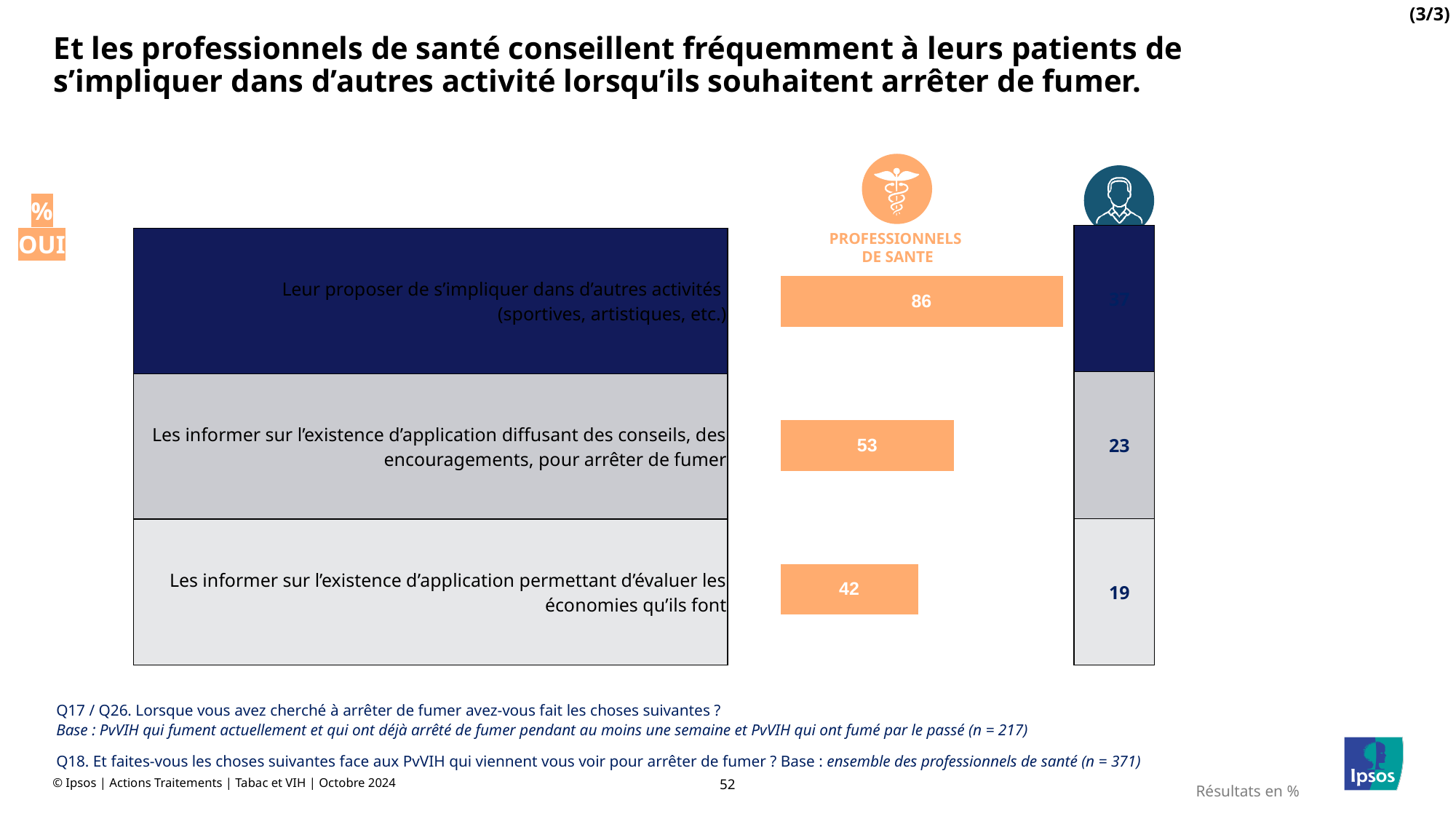
Which category has the highest value among the orange Professionnels de santé bars? Leur proposer de s'impliquer dans d'autres activités (sportives, artistiques, etc.) Which category has the lowest value among the orange Professionnels de santé bars? Les informer sur l'existence d'application permettant d'évaluer les économies qu'ils font For 'Les informer sur l'existence d'application diffusant des conseils', which is larger: the Professionnels de santé value or the right-hand column value? Professionnels de santé What is the difference between the Professionnels de santé values for 'Leur proposer de s'impliquer dans d'autres activités' and 'Les informer sur l'existence d'application diffusant des conseils'? 33 In the right-hand column, what value is shown for 'Les informer sur l'existence d'application diffusant des conseils, des encouragements, pour arrêter de fumer'? 23 In the right-hand column, what value is shown for 'Les informer sur l'existence d'application permettant d'évaluer les économies qu'ils font'? 19 How many categories are shown in the chart? 3 What value is shown for 'Les informer sur l'existence d'application diffusant des conseils, des encouragements, pour arrêter de fumer' in the orange Professionnels de santé bars? 53 What value is shown for 'Leur proposer de s'impliquer dans d'autres activités (sportives, artistiques, etc.)' in the orange Professionnels de santé bars? 86 What kind of chart is used to show the Professionnels de santé values? Bar chart What is the difference between the Professionnels de santé values for 'Les informer sur l'existence d'application diffusant des conseils' and 'Les informer sur l'existence d'application permettant d'évaluer les économies'? 11 What value is shown for 'Les informer sur l'existence d'application permettant d'évaluer les économies qu'ils font' in the orange Professionnels de santé bars? 42